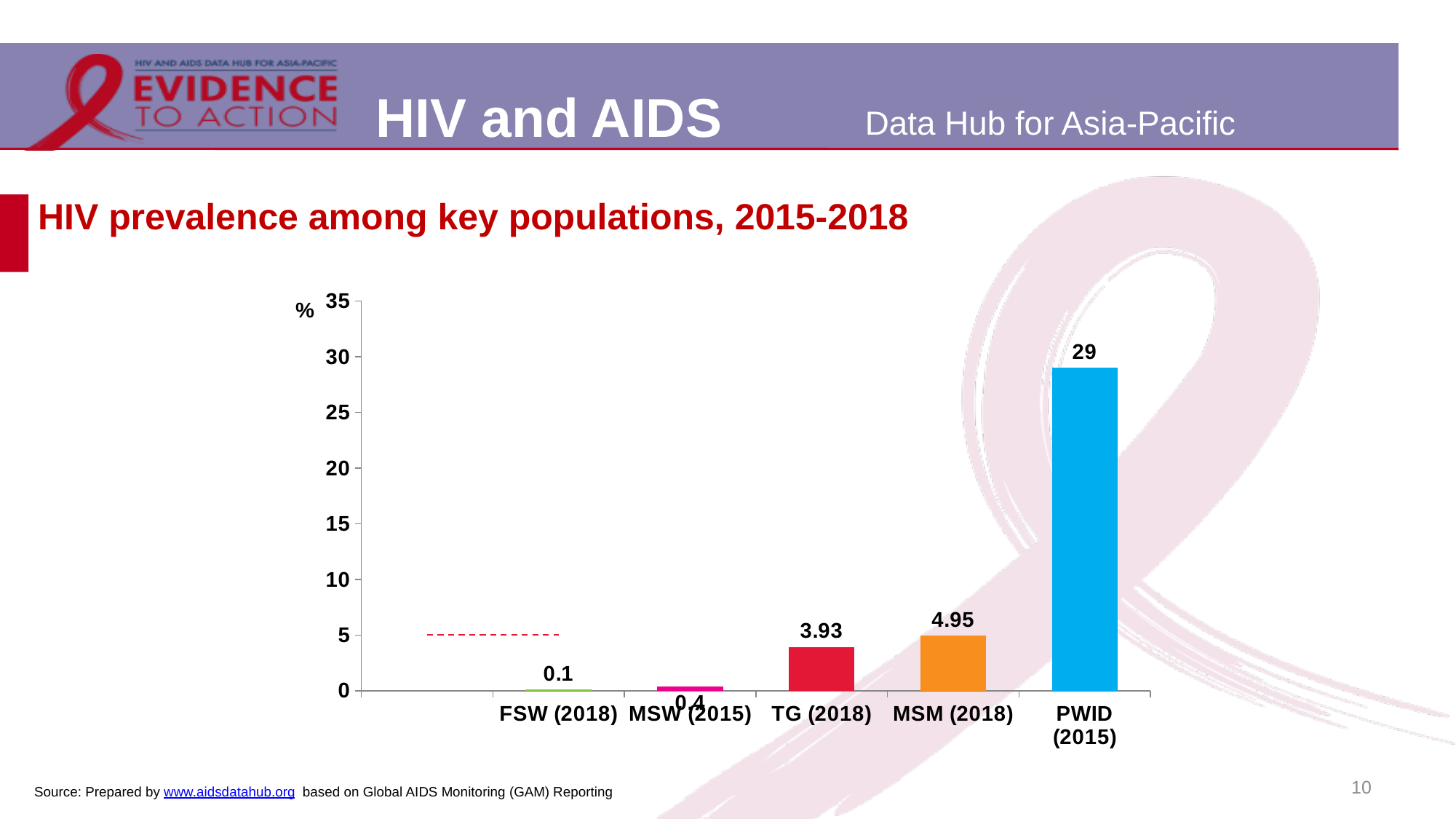
What is the HIV prevalence value shown for FSW (2018)? 0.1 What is the HIV prevalence value shown for PWID (2015)? 29 Which key population has the highest HIV prevalence in the chart? PWID (2015) Which has a higher HIV prevalence, TG (2018) or MSM (2018)? MSM (2018) What is the difference between the HIV prevalence for MSM (2018) and TG (2018)? 1.02 Is the value for PWID (2015) greater or less than 25? greater What is the HIV prevalence value shown for TG (2018)? 3.93 What is the HIV prevalence value shown for MSM (2018)? 4.95 What kind of chart is used to show HIV prevalence among key populations? bar chart How many key population categories are shown in the chart? 5 Which key population has the lowest HIV prevalence in the chart? FSW (2018) What is the difference between the HIV prevalence for PWID (2015) and MSM (2018)? 24.05